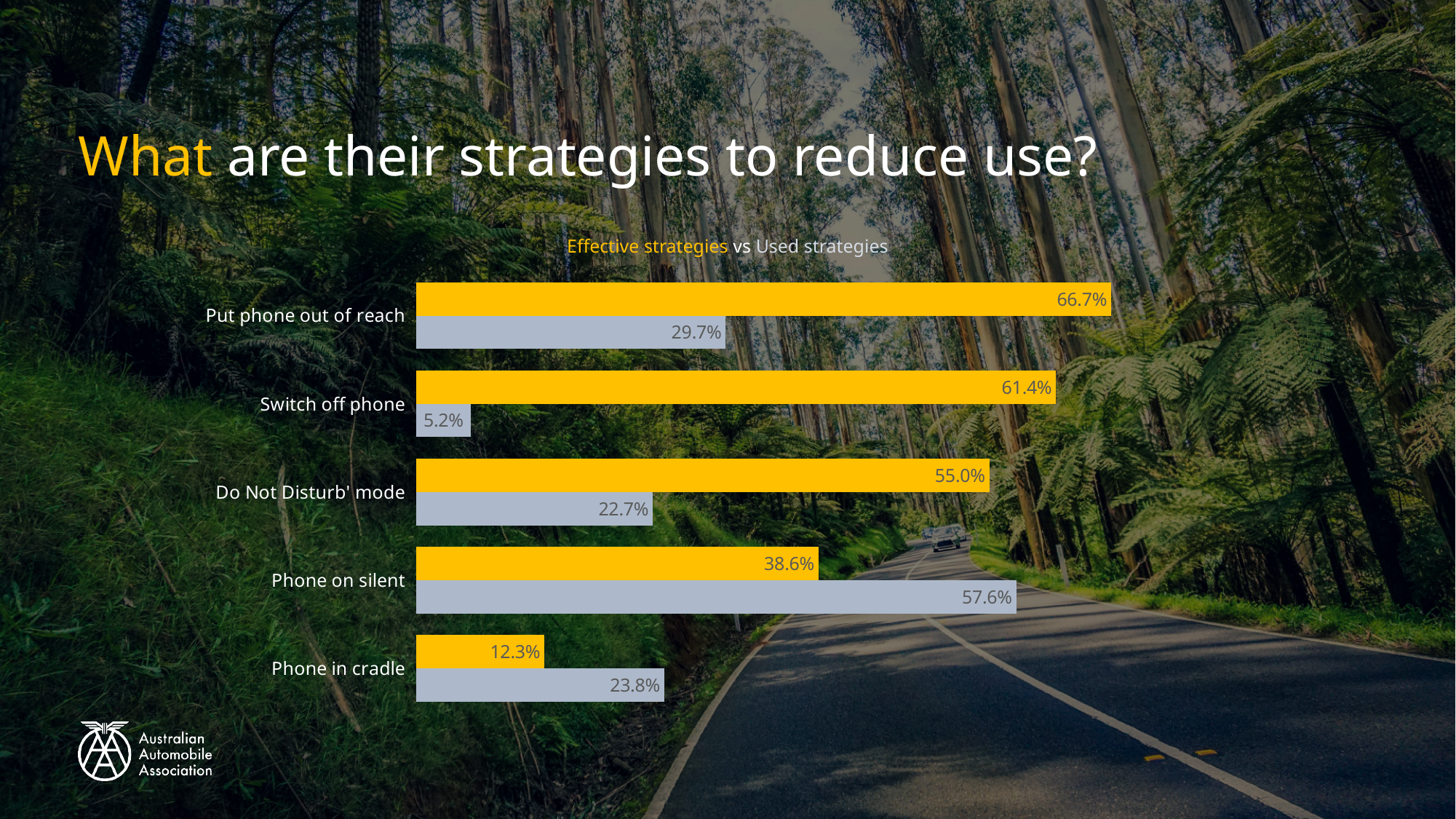
Which category has the highest Effective strategies value? Put phone out of reach What is the Used strategies value for Switch off phone? 5.2% What is the difference between the Effective and Used strategies values for Do Not Disturb' mode? 32.3% What is the Effective strategies value for Phone in cradle? 12.3% For Phone on silent, which is larger: the Effective strategies value or the Used strategies value? Used strategies How many series does the chart compare? 2 What kind of chart is shown on the slide? Bar chart Which category has the lowest Used strategies value? Switch off phone What is the Effective strategies value for Put phone out of reach? 66.7% How many categories are shown in the chart? 5 What is the Used strategies value for Phone on silent? 57.6% What colour are the Effective strategies bars? Yellow